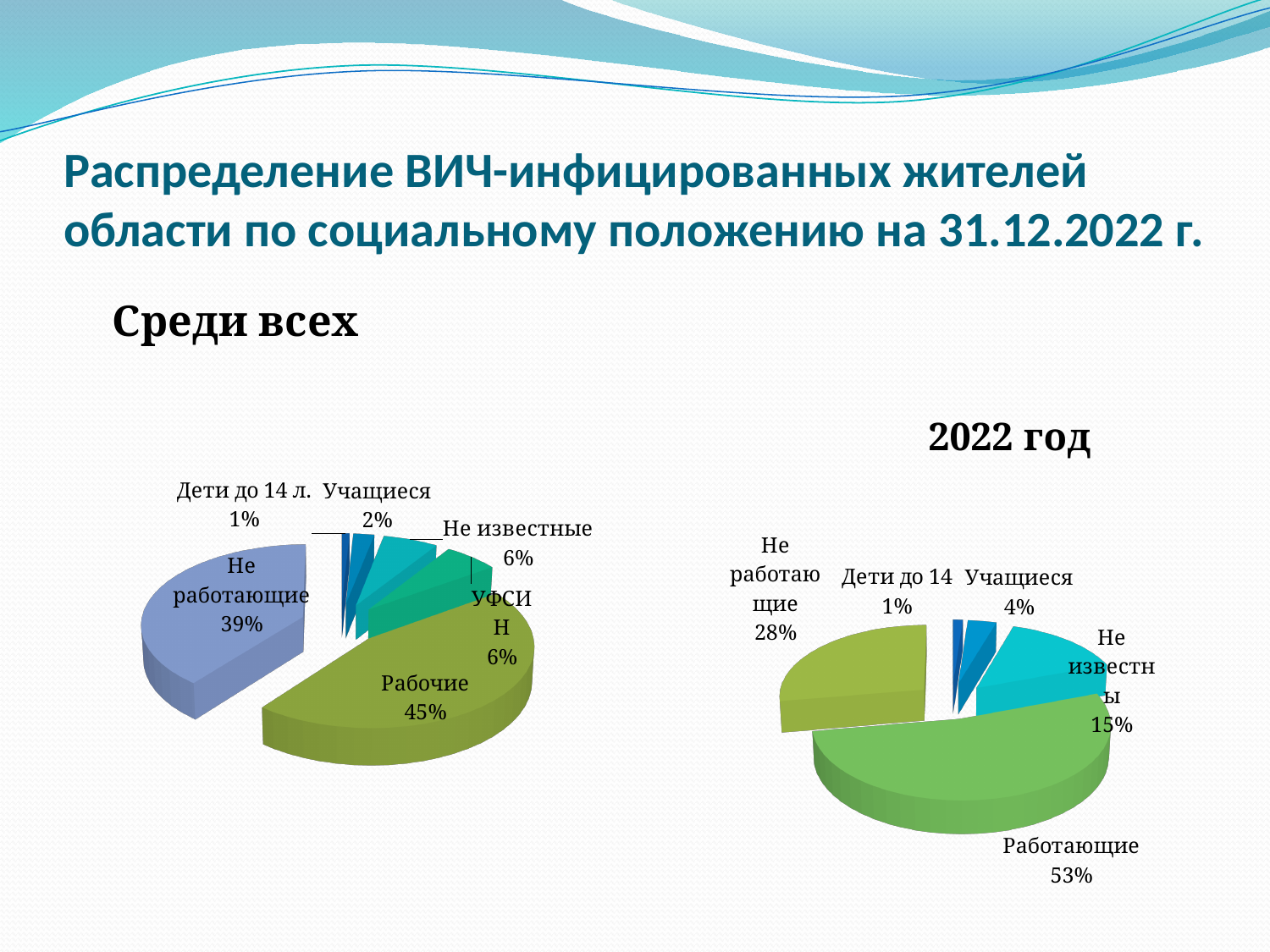
In the right pie chart ("2022 год"), what share is labelled for "Работающие"? 53% In the left pie chart ("Среди всех"), which category has the smallest share? Дети до 14 л. What type of chart is used on this slide? Pie chart In the left pie chart ("Среди всех"), which category has the largest share? Рабочие Which is larger: the share for "Учащиеся" in the left chart ("Среди всех") or in the right chart ("2022 год")? Right chart (2022 год) In the right pie chart ("2022 год"), what share is labelled for "Не известны"? 15% In the left pie chart ("Среди всех"), what share is labelled for "УФСИН"? 6% In the left pie chart ("Среди всех"), what share is labelled for "Не работающие"? 39% In the left pie chart ("Среди всех"), how many slices are labelled? 6 In the right pie chart ("2022 год"), which category has the largest share? Работающие In the left pie chart ("Среди всех"), what share is labelled for "Рабочие"? 45% In the right pie chart ("2022 год"), what is the difference between the shares for "Работающие" and "Не работающие"? 25 percentage points